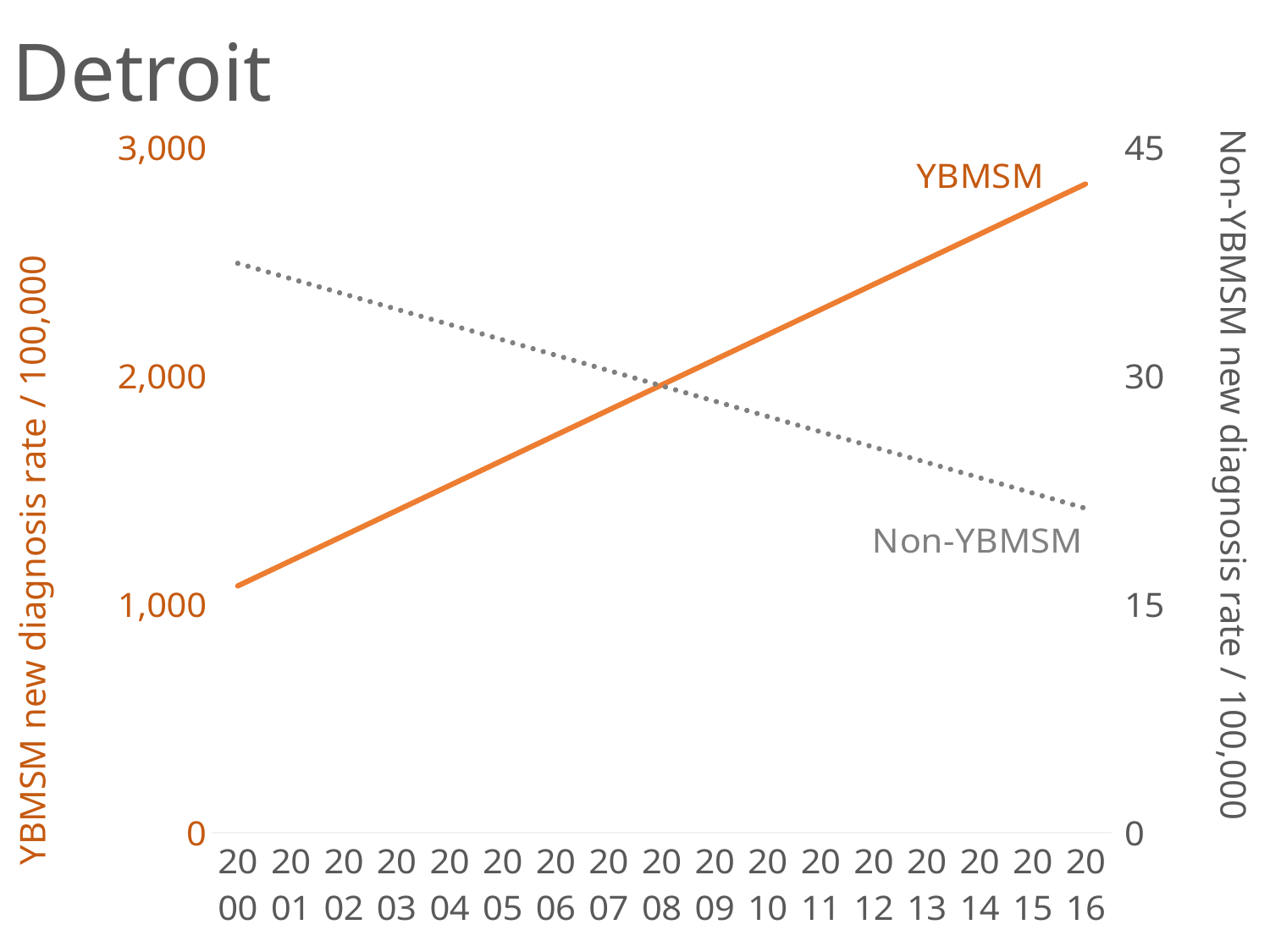
Is the YBMSM value for 2016 greater or less than 2,000? greater Is the YBMSM value for 2016 greater or less than 3,000? less Which series is drawn as a dotted line? Non-YBMSM How many data series are plotted on the chart? 2 Is the Non-YBMSM value for 2016 greater or less than 30? less Does the YBMSM new diagnosis rate rise or fall from 2000 to 2016? rise Does the Non-YBMSM new diagnosis rate rise or fall from 2000 to 2016? fall What kind of chart is shown on the slide? line chart What is the title of the chart? Detroit How many years are shown along the x axis? 17